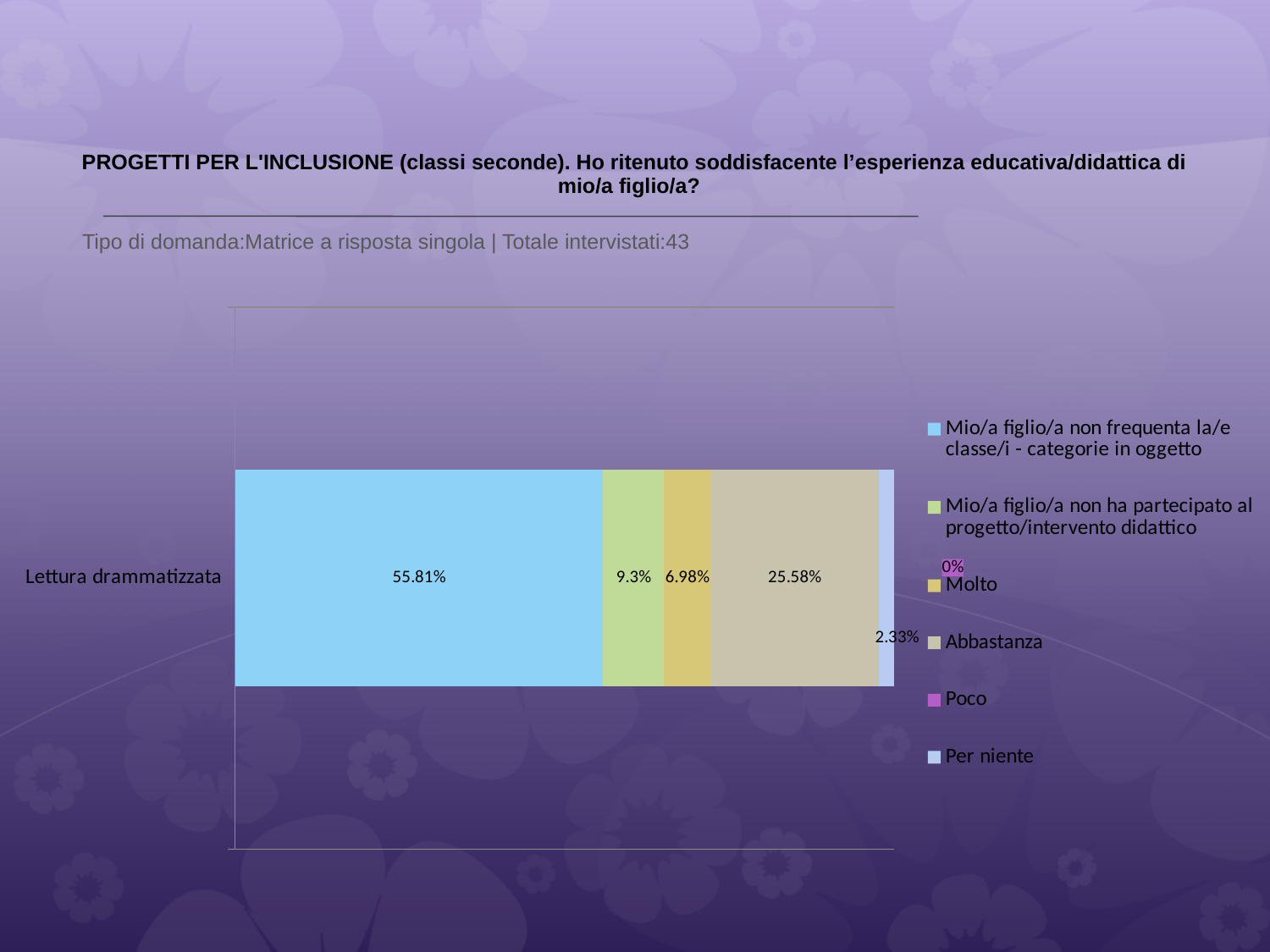
What is the value for 'Mio/a figlio/a non frequenta la/e classe/i - categorie in oggetto' for Lettura drammatizzata? 55.81% What kind of chart is shown on the slide? stacked bar chart What is the value for 'Molto' for Lettura drammatizzata? 6.98% What is the value for 'Poco' for Lettura drammatizzata? 0% Which is larger for Lettura drammatizzata, 'Abbastanza' or 'Molto'? Abbastanza What is the value for 'Per niente' for Lettura drammatizzata? 2.33% How many series does the legend list? 6 Which series has the highest value for Lettura drammatizzata? Mio/a figlio/a non frequenta la/e classe/i - categorie in oggetto How many categories are plotted on the chart? 1 What is the value for 'Abbastanza' for Lettura drammatizzata? 25.58% What is the difference between the 'Abbastanza' and 'Molto' values for Lettura drammatizzata? 18.6% What is the value for 'Mio/a figlio/a non ha partecipato al progetto/intervento didattico' for Lettura drammatizzata? 9.3%